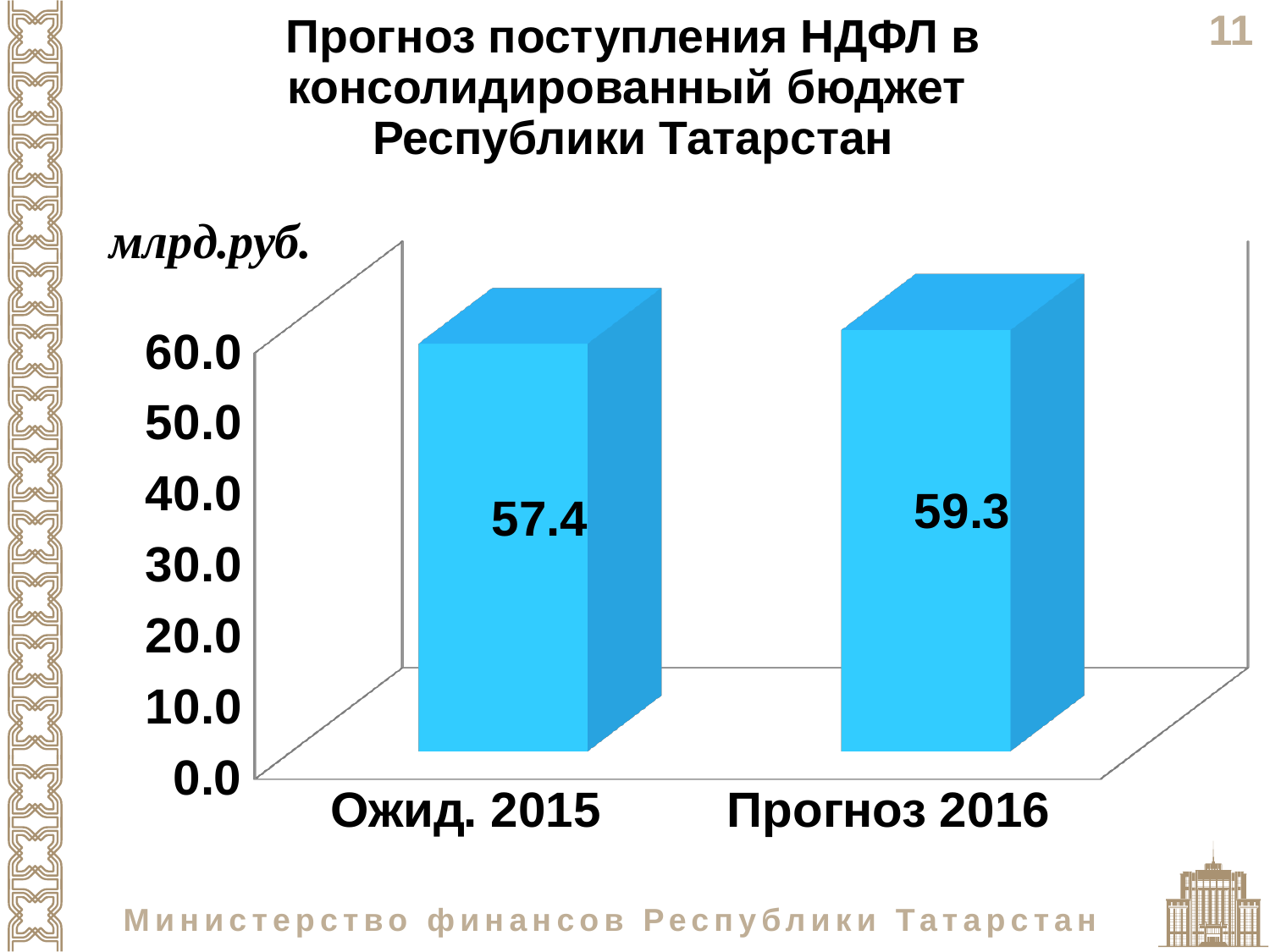
What is the value for Ожид. 2015? 57.4 How many categories are shown on the x axis? 2 Do the values rise or fall from Ожид. 2015 to Прогноз 2016? rise Is the value for Ожид. 2015 greater or less than 50.0? greater Which is larger, the value for Ожид. 2015 or the value for Прогноз 2016? Прогноз 2016 What is the difference between the values for Прогноз 2016 and Ожид. 2015? 1.9 What is the value for Прогноз 2016? 59.3 What is the title of the chart? Прогноз поступления НДФЛ в консолидированный бюджет Республики Татарстан What kind of chart is shown on the slide? bar chart What unit is shown for the values on the chart? млрд.руб. Which category has the highest value? Прогноз 2016 Which category has the lowest value? Ожид. 2015